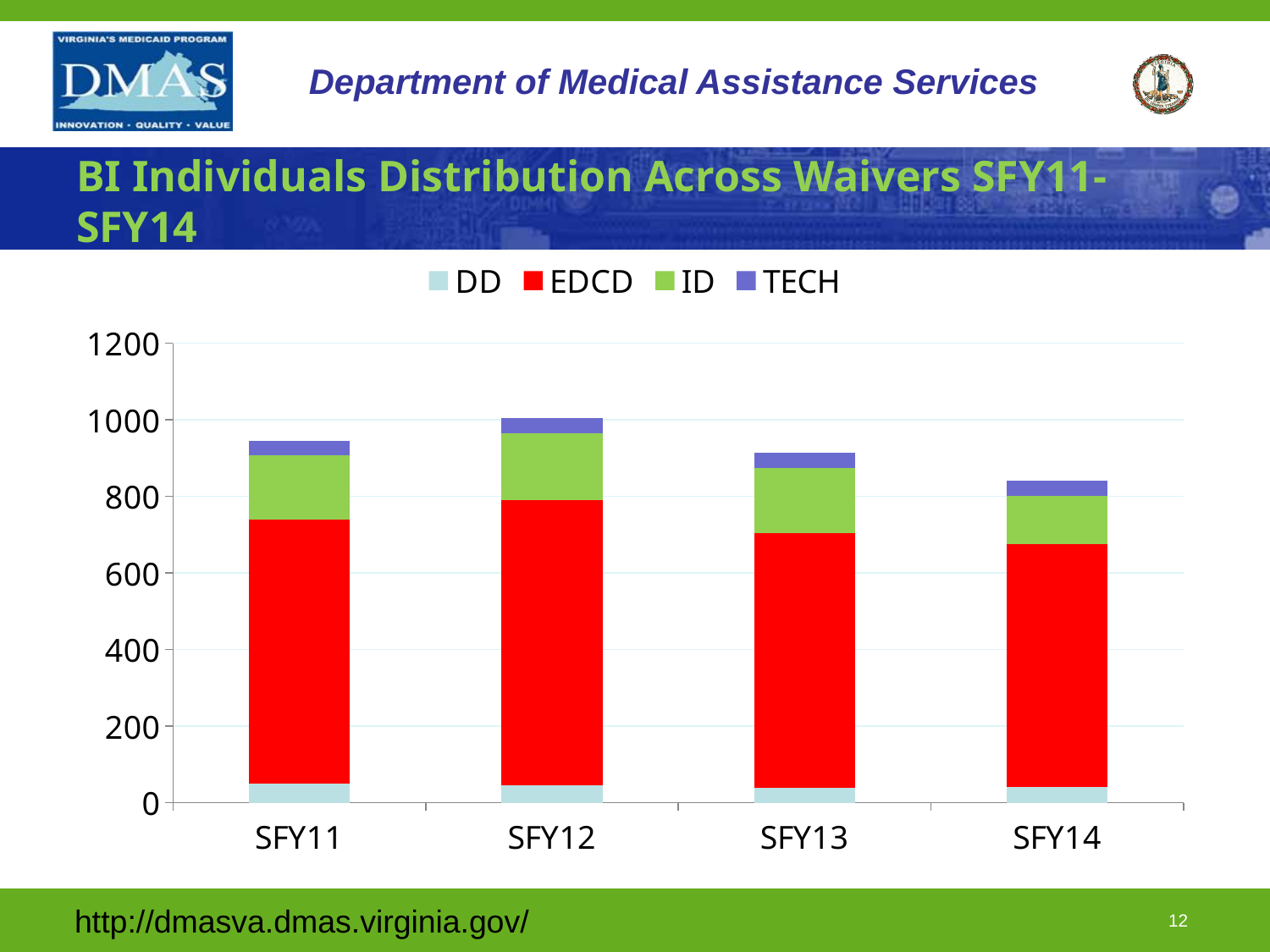
What is the title of the chart? BI Individuals Distribution Across Waivers SFY11-SFY14 Which is larger, the total stacked bar for SFY12 or for SFY14? SFY12 Is the total stacked bar for SFY14 greater or less than 1000? less Which fiscal year has the tallest stacked bar? SFY12 Do the stacked bar totals rise or fall from SFY12 to SFY14? fall Which series makes up the largest segment of every bar? EDCD Is the total stacked bar for SFY13 greater or less than 1000? less What kind of chart is shown on the slide? Stacked bar chart Is the total stacked bar for SFY11 greater or less than 800? greater Which fiscal year has the shortest stacked bar? SFY14 How many series does the legend list? 4 How many fiscal years (categories) are shown on the x axis? 4